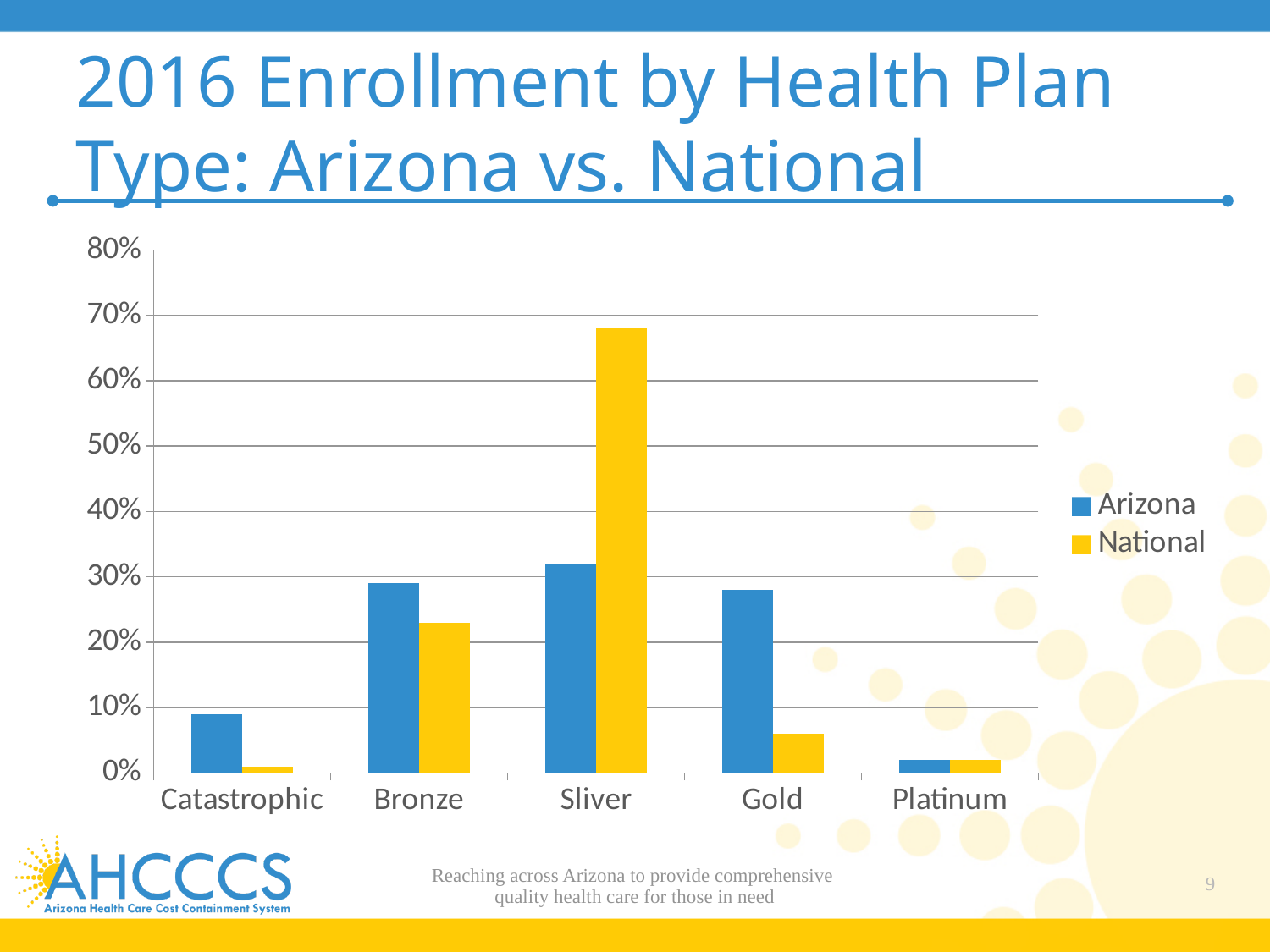
For Sliver, which is larger: the Arizona value or the National value? National Is the Arizona value for Catastrophic greater or less than 10%? less What colour are the National bars in the chart? yellow For Gold, which is larger: the Arizona value or the National value? Arizona What kind of chart is shown on the slide? bar chart Is the National value for Bronze greater or less than 20%? greater Which health plan type has the highest National enrollment share? Sliver How many health plan types are shown on the x axis? 5 Which health plan type has the lowest Arizona enrollment share? Platinum Is the National value for Gold greater or less than 10%? less How many series does the legend list? 2